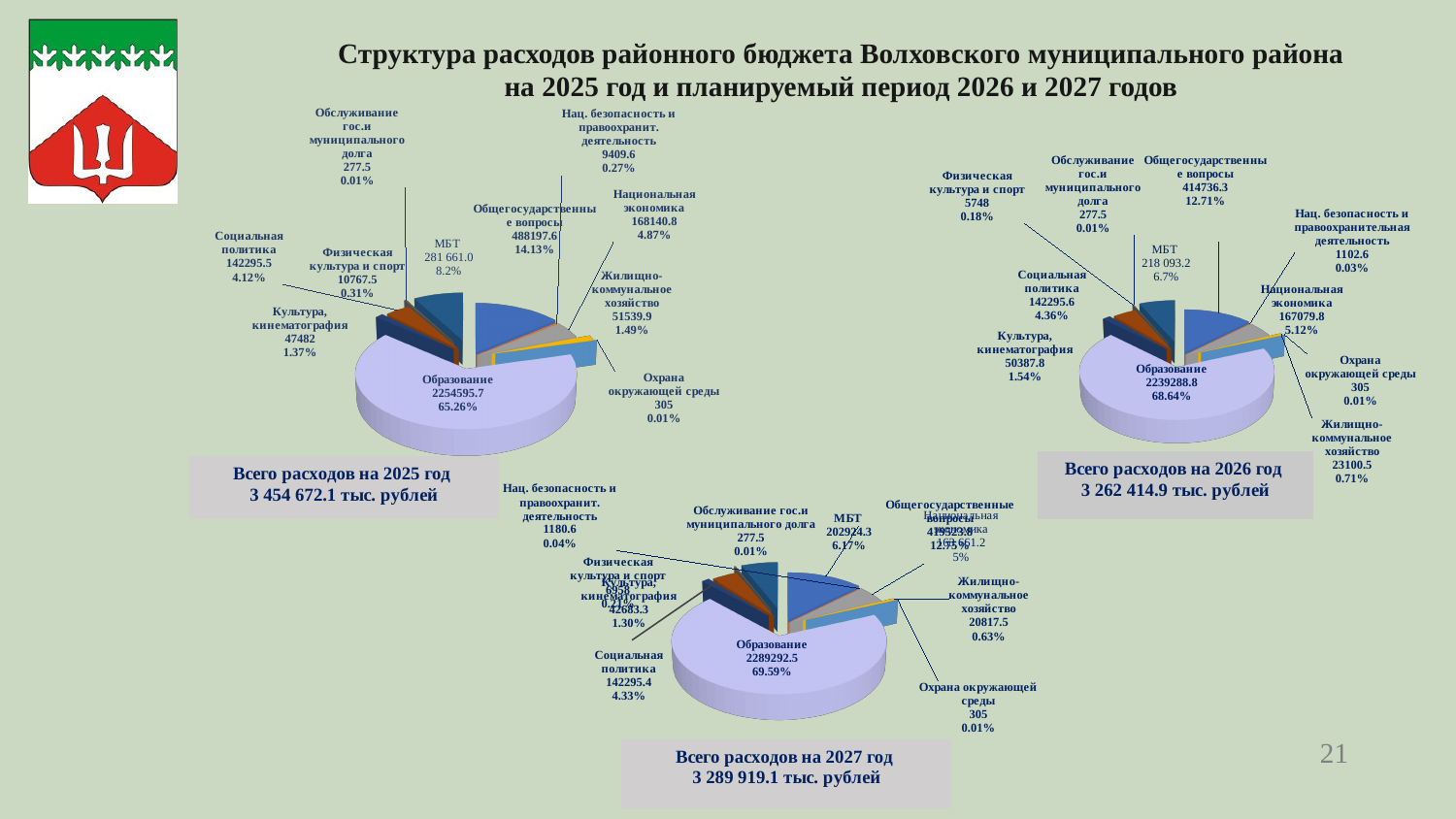
On the 2025 pie chart (left), what share of expenditures goes to Образование? 65.26% On the 2025 pie chart (left), which category has the largest share? Образование On the 2026 pie chart (right), what share of expenditures goes to МБТ? 6.7% What is the total of expenditures shown for 2027 (bottom chart)? 3 289 919.1 тыс. рублей On the 2025 pie chart (left), what is the value for Общегосударственные вопросы? 488197.6 On the 2026 pie chart (right), which is larger: Социальная политика or Культура, кинематография? Социальная политика What type of chart is used on this slide? Pie chart On the 2027 pie chart (bottom), what share of expenditures goes to Жилищно-коммунальное хозяйство? 0.63% What is the difference between the Образование values on the 2026 chart (right) and the 2025 chart (left)? 15306.9 On the 2027 pie chart (bottom), what is the value for Образование? 2289292.5 How many pie charts are shown on the slide? 3 On the 2026 pie chart (right), what is the value for Национальная экономика? 167079.8